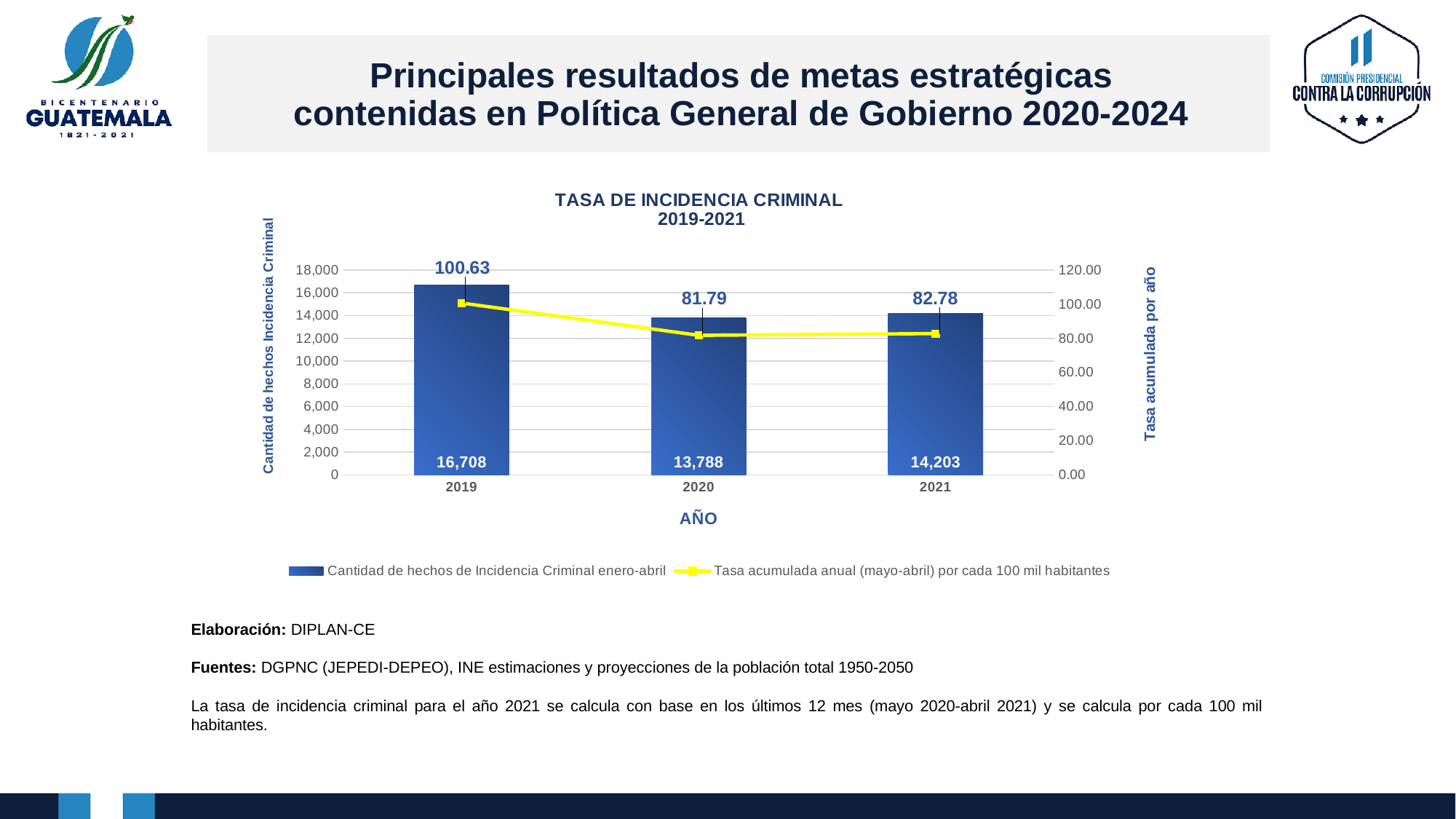
Which year has a larger 'Cantidad de hechos de Incidencia Criminal enero-abril', 2020 or 2021? 2021 How many series does the chart legend list? 2 How many years are shown on the x axis of the chart? 3 What is the 'Tasa acumulada anual (mayo-abril) por cada 100 mil habitantes' for 2019? 100.63 What is the title of the chart? TASA DE INCIDENCIA CRIMINAL 2019-2021 What kind of chart is used to show 'Cantidad de hechos de Incidencia Criminal enero-abril'? Bar chart Which year has the highest 'Cantidad de hechos de Incidencia Criminal enero-abril'? 2019 What is the 'Tasa acumulada anual (mayo-abril) por cada 100 mil habitantes' for 2021? 82.78 What is the difference in 'Cantidad de hechos de Incidencia Criminal enero-abril' between 2019 and 2020? 2,920 What is the value of 'Cantidad de hechos de Incidencia Criminal enero-abril' for 2019? 16,708 Which year has the lowest 'Tasa acumulada anual (mayo-abril) por cada 100 mil habitantes'? 2020 What is the value of 'Cantidad de hechos de Incidencia Criminal enero-abril' for 2020? 13,788